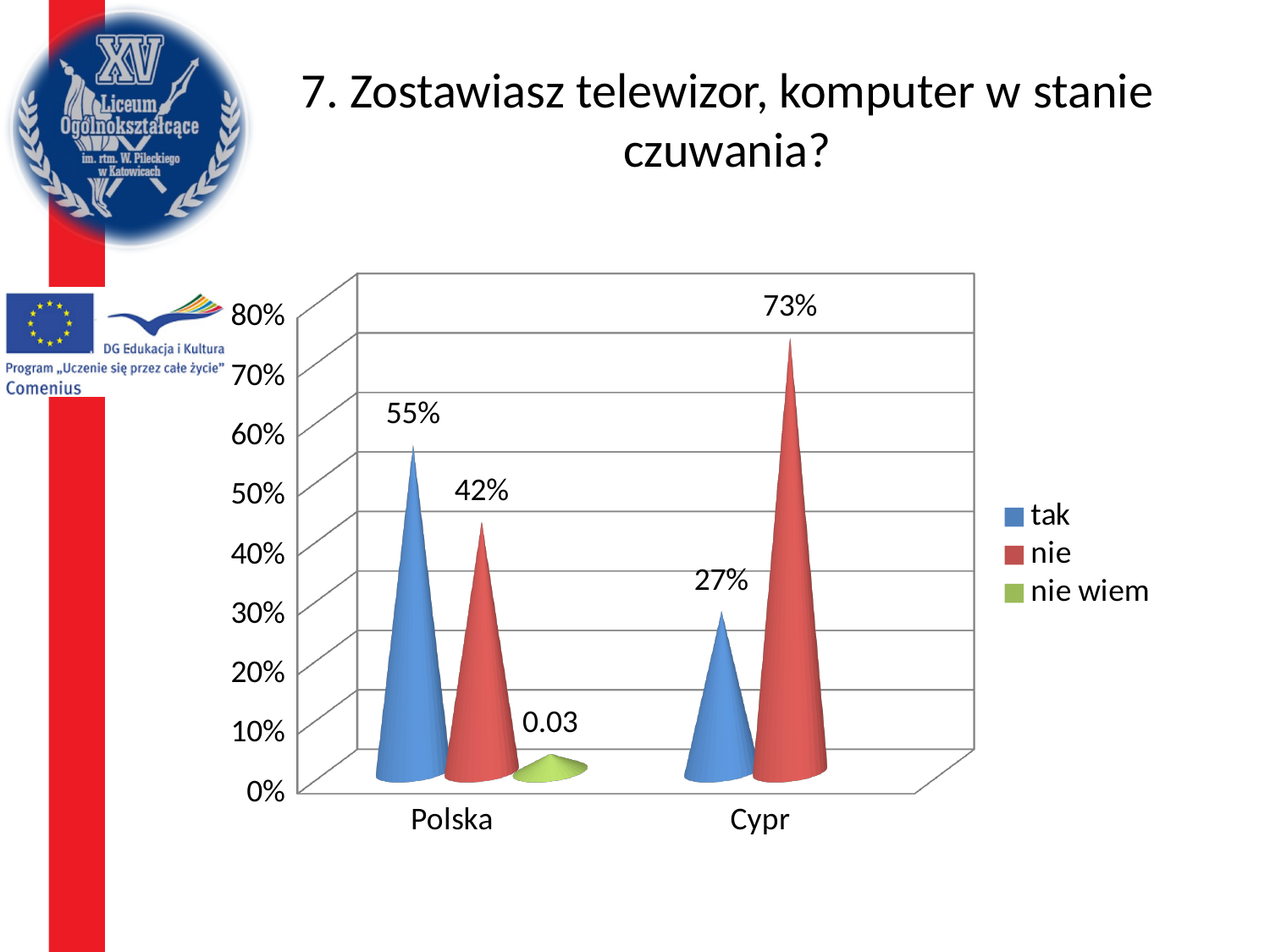
What data label is shown for "nie wiem" in Polska? 0.03 What is the value for "nie" in Cypr? 73% How many categories are shown on the x axis? 2 What is the difference between the "tak" and "nie" values for Polska? 13% What is the value for "tak" in Polska? 55% What is the difference between the "nie" values for Cypr and Polska? 31% Which category has the higher value for "nie", Polska or Cypr? Cypr What is the title of the slide containing the chart? 7. Zostawiasz telewizor, komputer w stanie czuwania? Which category has the higher value for "tak", Polska or Cypr? Polska What is the value for "tak" in Cypr? 27% How many series does the legend list? 3 What is the value for "nie" in Polska? 42%